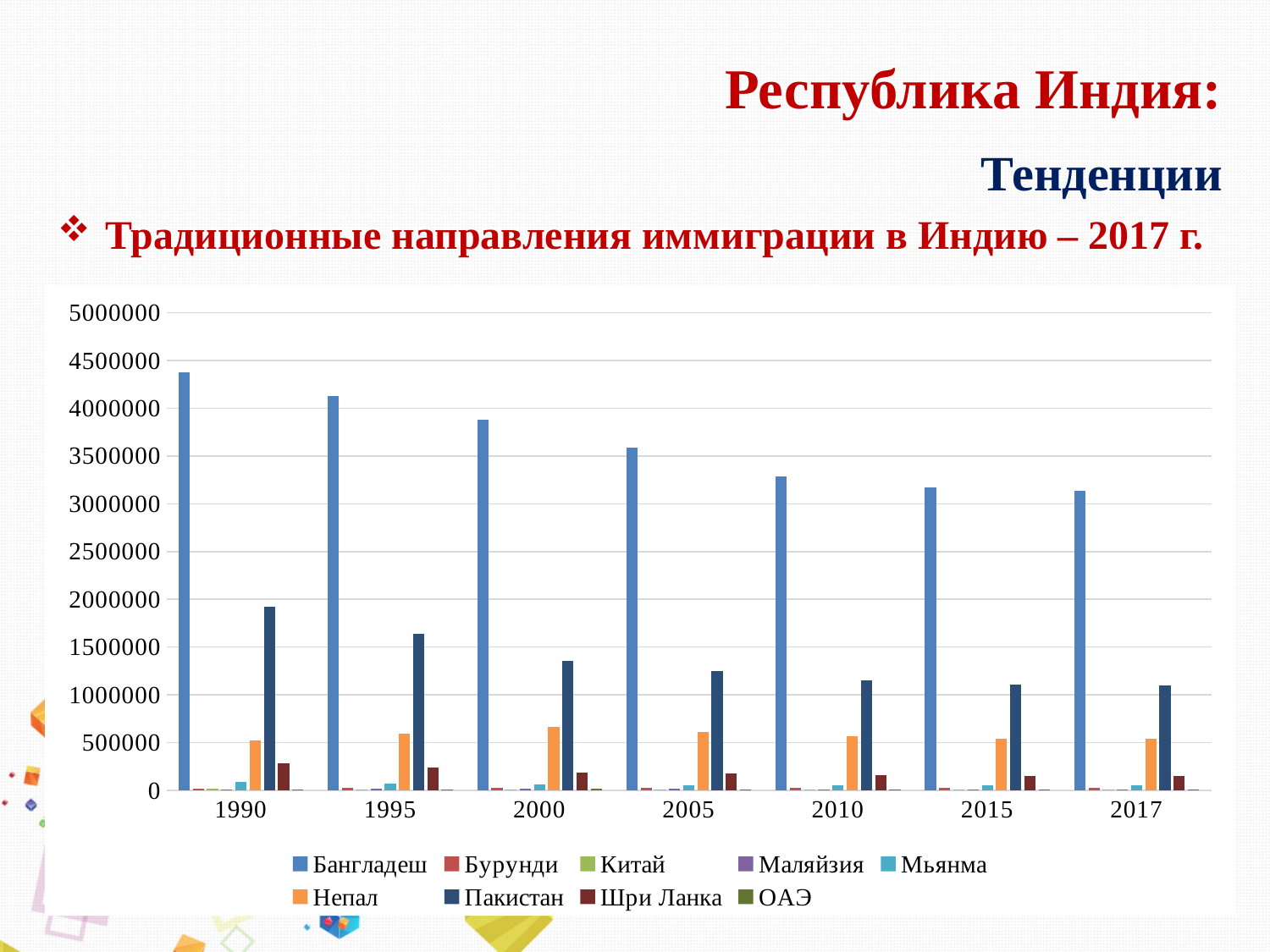
Which year has the highest value for Бангладеш? 1990 Which series has the highest value in 1990? Бангладеш Do the values for Бангладеш rise or fall from 1990 to 2017? fall In 2005, which is larger: the value for Пакистан or the value for Непал? Пакистан How many years are shown along the x axis of the chart? 7 What kind of chart is shown on the slide? bar chart Is the value for Пакистан in 2017 greater or less than 1500000? less Which series has the second-highest value in 2000? Пакистан Is the value for Пакистан in 1990 greater or less than 1500000? greater Is the value for Непал in 2000 greater or less than 500000? greater How many series does the chart's legend list? 9